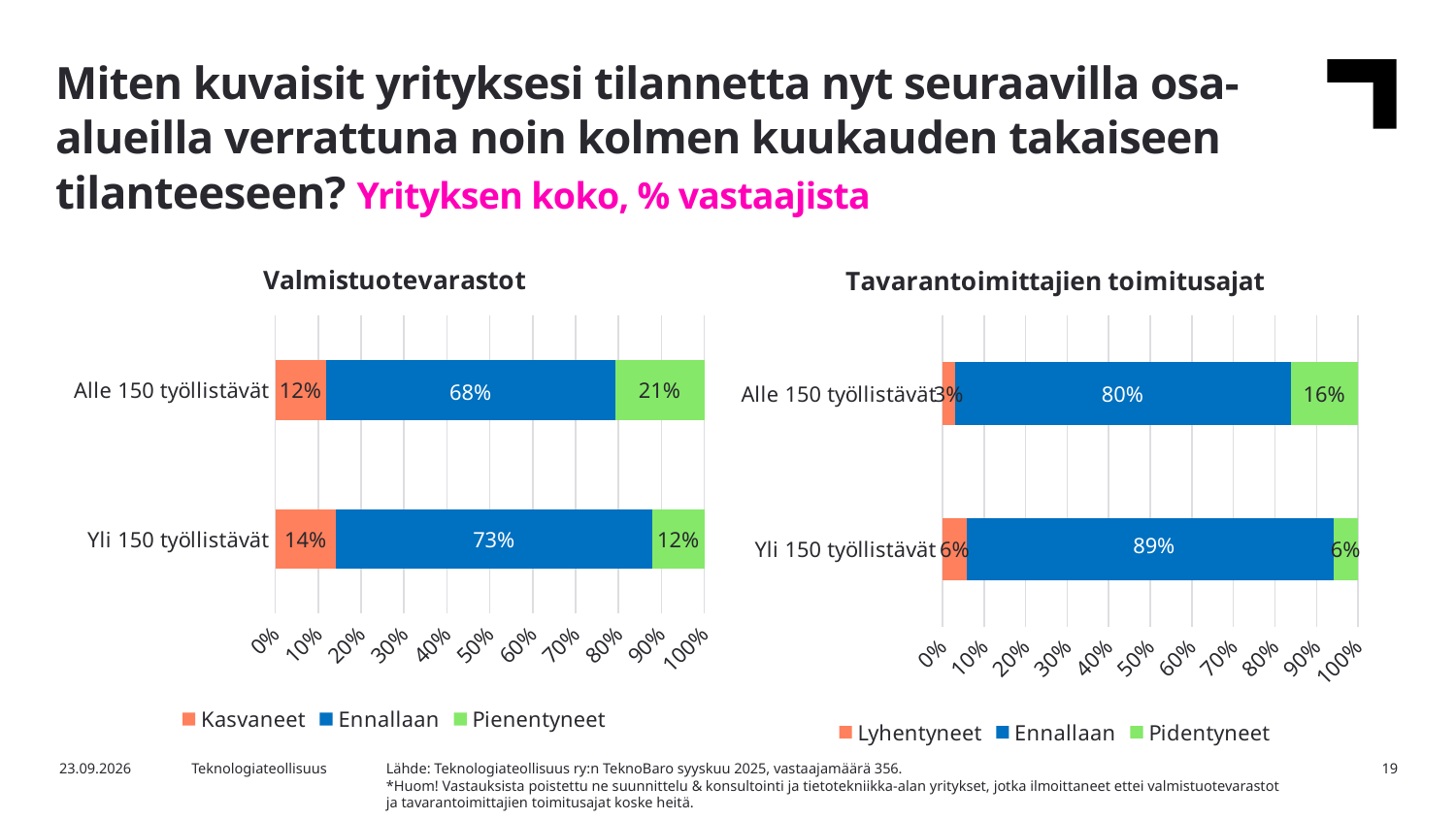
How many series does the legend of the Tavarantoimittajien toimitusajat chart list? 3 In the Valmistuotevarastot chart, what is the Pienentyneet value for Yli 150 työllistävät? 12% In the Tavarantoimittajien toimitusajat chart, what is the Lyhentyneet value for Yli 150 työllistävät? 6% In the Valmistuotevarastot chart, what is the Kasvaneet value for Yli 150 työllistävät? 14% What kind of chart is the Valmistuotevarastot chart? Stacked bar chart In the Valmistuotevarastot chart, what is the Ennallaan value for Alle 150 työllistävät? 68% In the Tavarantoimittajien toimitusajat chart, what is the Pidentyneet value for Alle 150 työllistävät? 16% In the Tavarantoimittajien toimitusajat chart, what is the Ennallaan value for Yli 150 työllistävät? 89% In the Valmistuotevarastot chart, what is the difference between the Ennallaan values for Yli 150 työllistävät and Alle 150 työllistävät? 5 percentage points In the Valmistuotevarastot chart, which category has the higher Pienentyneet value? Alle 150 työllistävät How many categories are shown in the Tavarantoimittajien toimitusajat chart? 2 In the Tavarantoimittajien toimitusajat chart, which category has the higher Ennallaan value? Yli 150 työllistävät